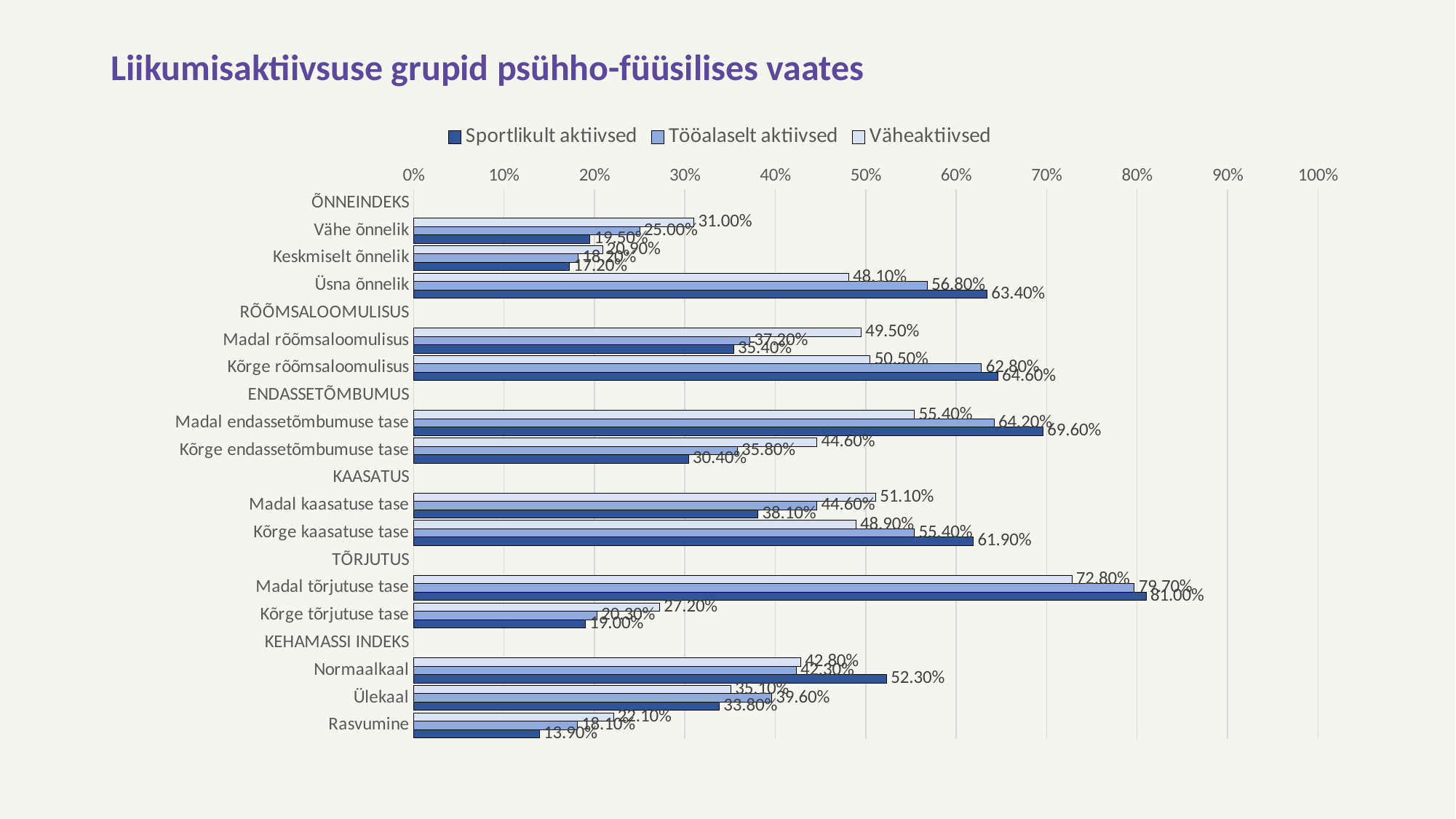
What is the difference between the Sportlikult aktiivsed and Väheaktiivsed values in the Üsna õnnelik category? 15.30% How many series does the legend list? 3 What kind of chart is shown on the slide? Bar chart Which category has the highest value for Sportlikult aktiivsed? Madal tõrjutuse tase In the Normaalkaal category, which is larger: the Sportlikult aktiivsed value or the Väheaktiivsed value? Sportlikult aktiivsed What is the title of the slide? Liikumisaktiivsuse grupid psühho-füüsilises vaates What is the value for Tööalaselt aktiivsed in the Üsna õnnelik category? 56.80% What is the value for Väheaktiivsed in the Vähe õnnelik category? 31.00% What is the value for Sportlikult aktiivsed in the Rasvumine category? 13.90% Is the value for Väheaktiivsed in the Madal tõrjutuse tase category greater or less than 70%? greater Which category has the lowest value for Väheaktiivsed? Keskmiselt õnnelik What is the value for Sportlikult aktiivsed in the Madal tõrjutuse tase category? 81.00%